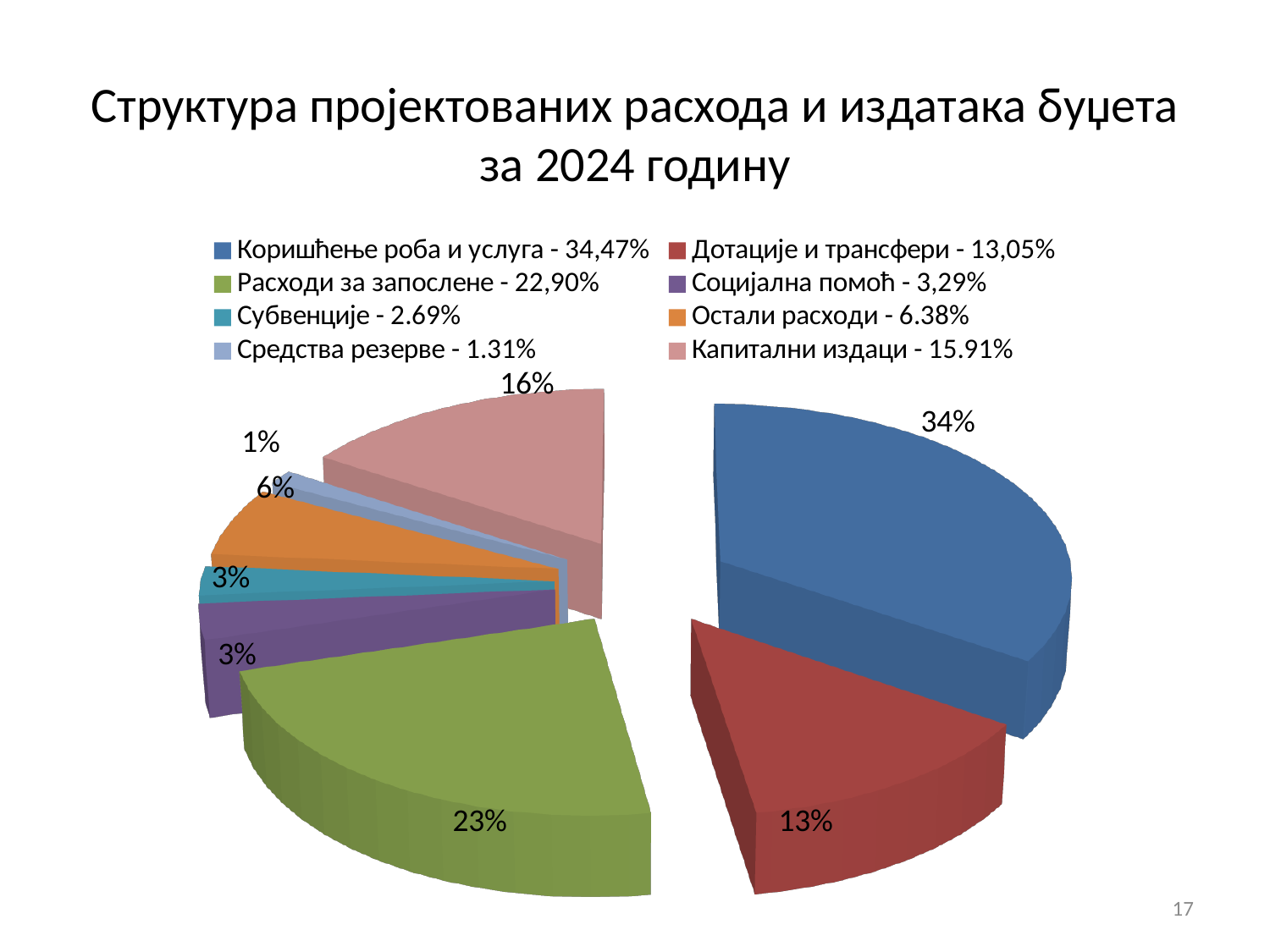
Which category has the smallest slice of the pie? Средства резерве What kind of chart is shown on the slide? pie chart Which category has the largest slice of the pie? Коришћење роба и услуга How many slices does the pie chart have? 8 What is the title of the chart on the slide? Структура пројектованих расхода и издатака буџета за 2024 годину What percentage label is shown on the slice for Дотације и трансфери? 13% Which is larger, the slice for Остали расходи or the slice for Субвенције? Остали расходи What is the difference between the slice labels for Коришћење роба и услуга and Дотације и трансфери? 21% What percentage label is shown on the slice for Расходи за запослене? 23% What percentage label is shown on the slice for Капитални издаци? 16% What percentage label is shown on the slice for Коришћење роба и услуга? 34% According to the legend, what exact share does Социјална помоћ have? 3,29%